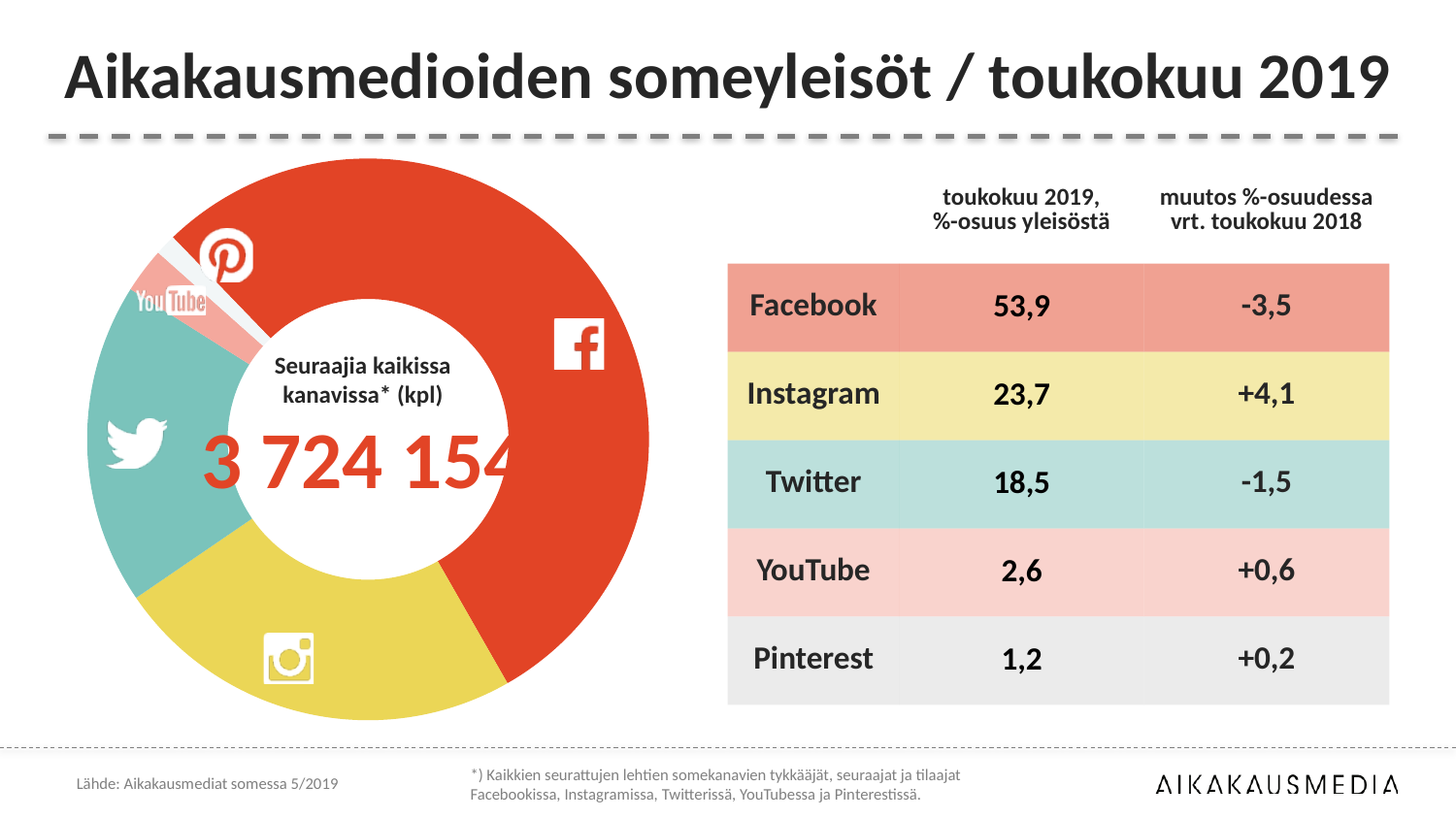
What kind of chart is shown on the left of the slide? Donut (pie) chart Which channel has a larger share of the audience in May 2019, Twitter or YouTube? Twitter According to the table, what is Facebook's share of the audience in May 2019 (toukokuu 2019, %-osuus yleisöstä)? 53,9 How many slices does the donut chart have? 5 Which channel has the smallest slice of the donut chart? Pinterest What colour is the Twitter slice in the donut chart? Teal (turquoise) According to the table, what is Instagram's share of the audience in May 2019? 23,7 Which channel shows the largest positive change in percentage share compared with May 2018? Instagram What total number of followers is printed in the centre of the donut chart? 3 724 154 Which channel has the largest slice of the donut chart? Facebook What is the difference between Facebook's and Instagram's share of the audience in May 2019? 30,2 According to the table, what is the change in percentage share for Twitter compared with May 2018? -1,5